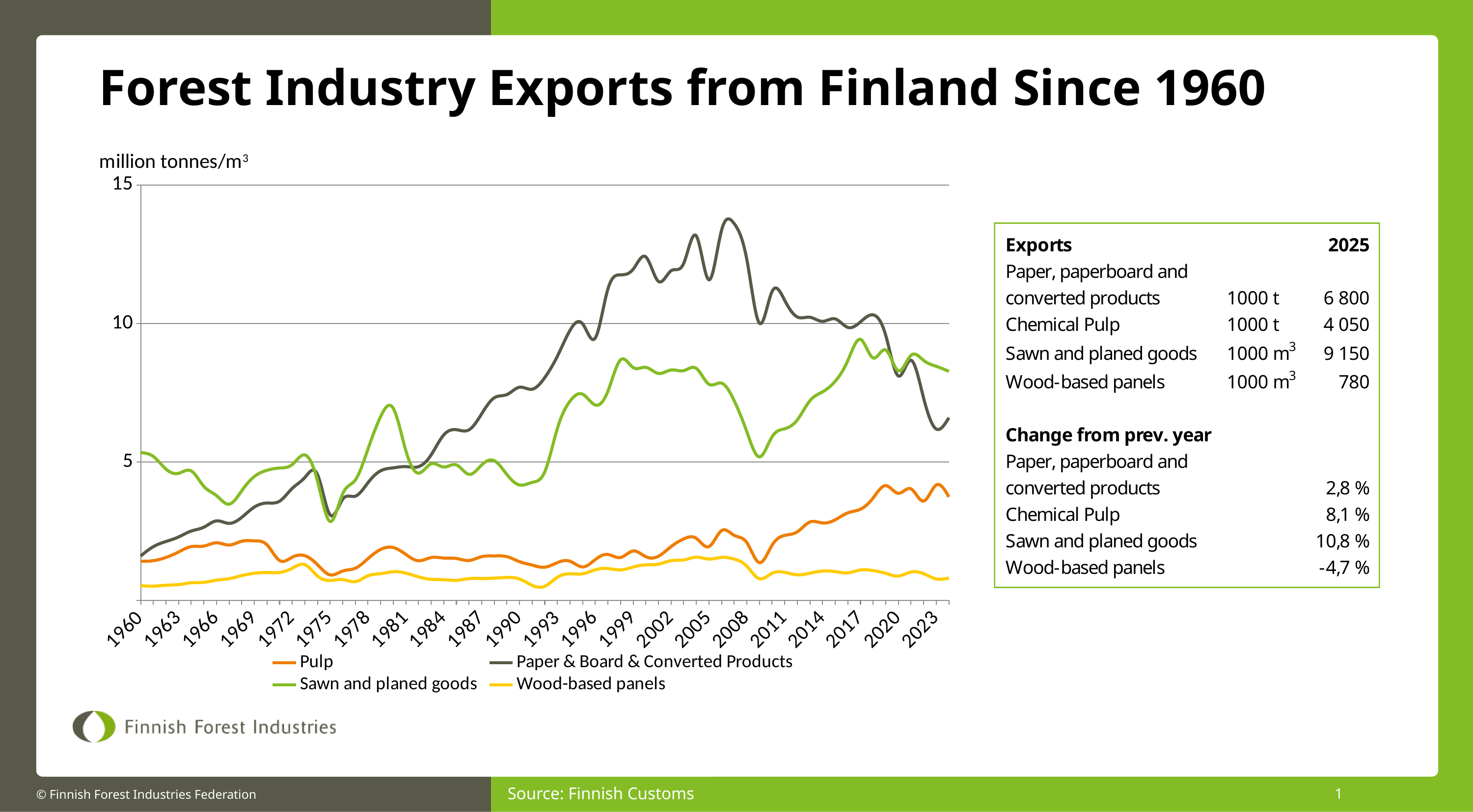
Is the value for Pulp in 2023 greater or less than 5? less Which series has the lowest values across the whole period shown? Wood-based panels How many series does the chart legend list? 4 What unit is shown on the chart's vertical axis? million tonnes/m³ Which series reaches the highest value on the chart around 2008? Paper & Board & Converted Products What kind of chart is shown on the slide? line chart Does the Paper & Board & Converted Products line rise or fall between 2008 and 2023? fall Is the value for Paper & Board & Converted Products around 2008 greater or less than 10? greater What is the title of the slide's chart? Forest Industry Exports from Finland Since 1960 Is the value for Paper & Board & Converted Products in 1960 greater or less than 5? less Around 2005, which is higher: Paper & Board & Converted Products or Sawn and planed goods? Paper & Board & Converted Products In 2023, which is higher: Sawn and planed goods or Paper & Board & Converted Products? Sawn and planed goods